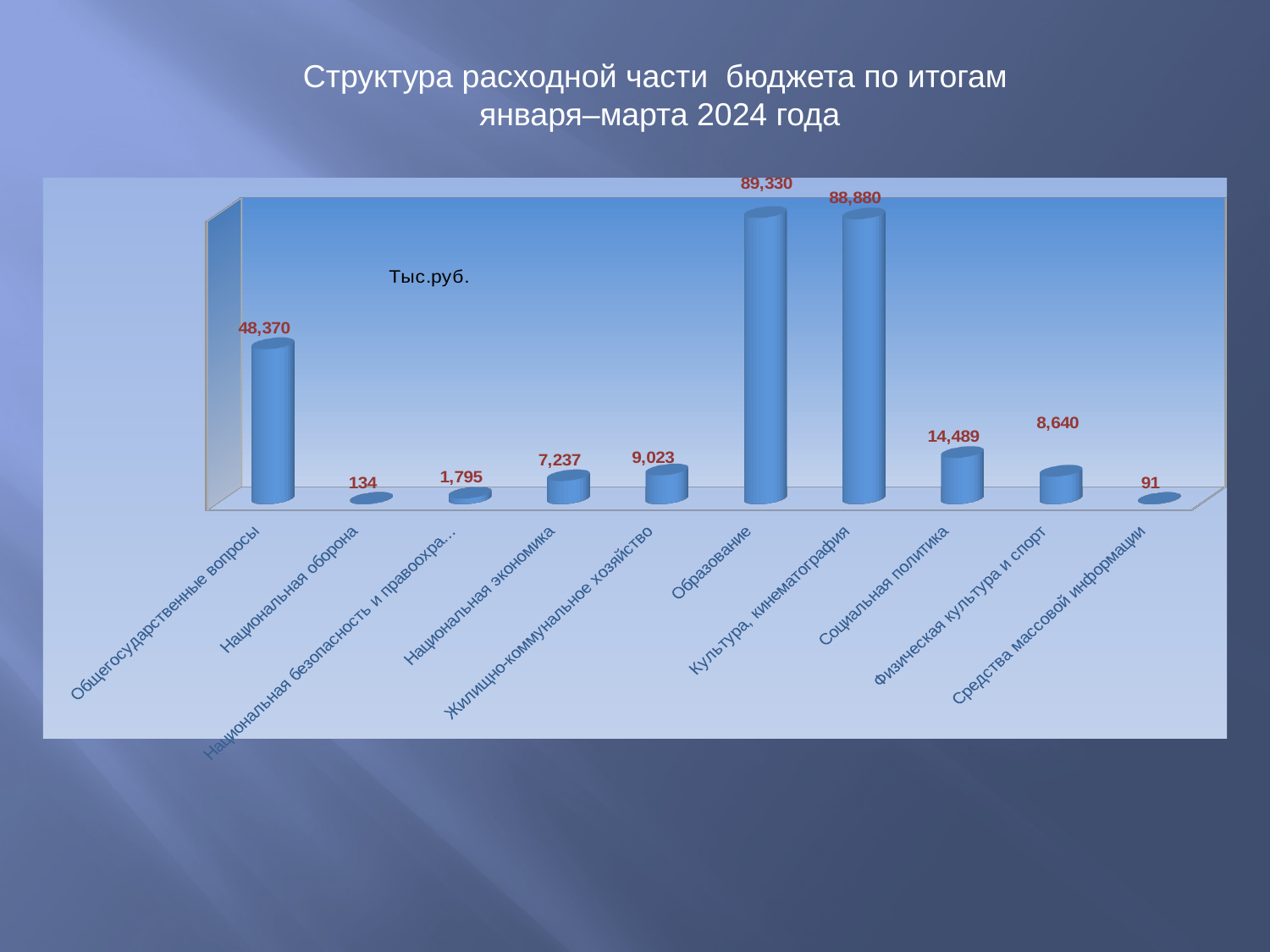
What unit label is shown inside the chart area? Тыс.руб. Which is larger, the value for Физическая культура и спорт or the value for Жилищно-коммунальное хозяйство? Жилищно-коммунальное хозяйство What is the value for Образование? 89,330 What is the value for Национальная оборона? 134 What is the difference between the values for Жилищно-коммунальное хозяйство and Национальная экономика? 1,786 Which category has the lowest value? Средства массовой информации What is the difference between the values for Образование and Культура, кинематография? 450 What kind of chart is shown on the slide? Bar chart What is the value for Социальная политика? 14,489 How many categories are shown in the chart? 10 What is the value for Общегосударственные вопросы? 48,370 Which category has the highest value? Образование